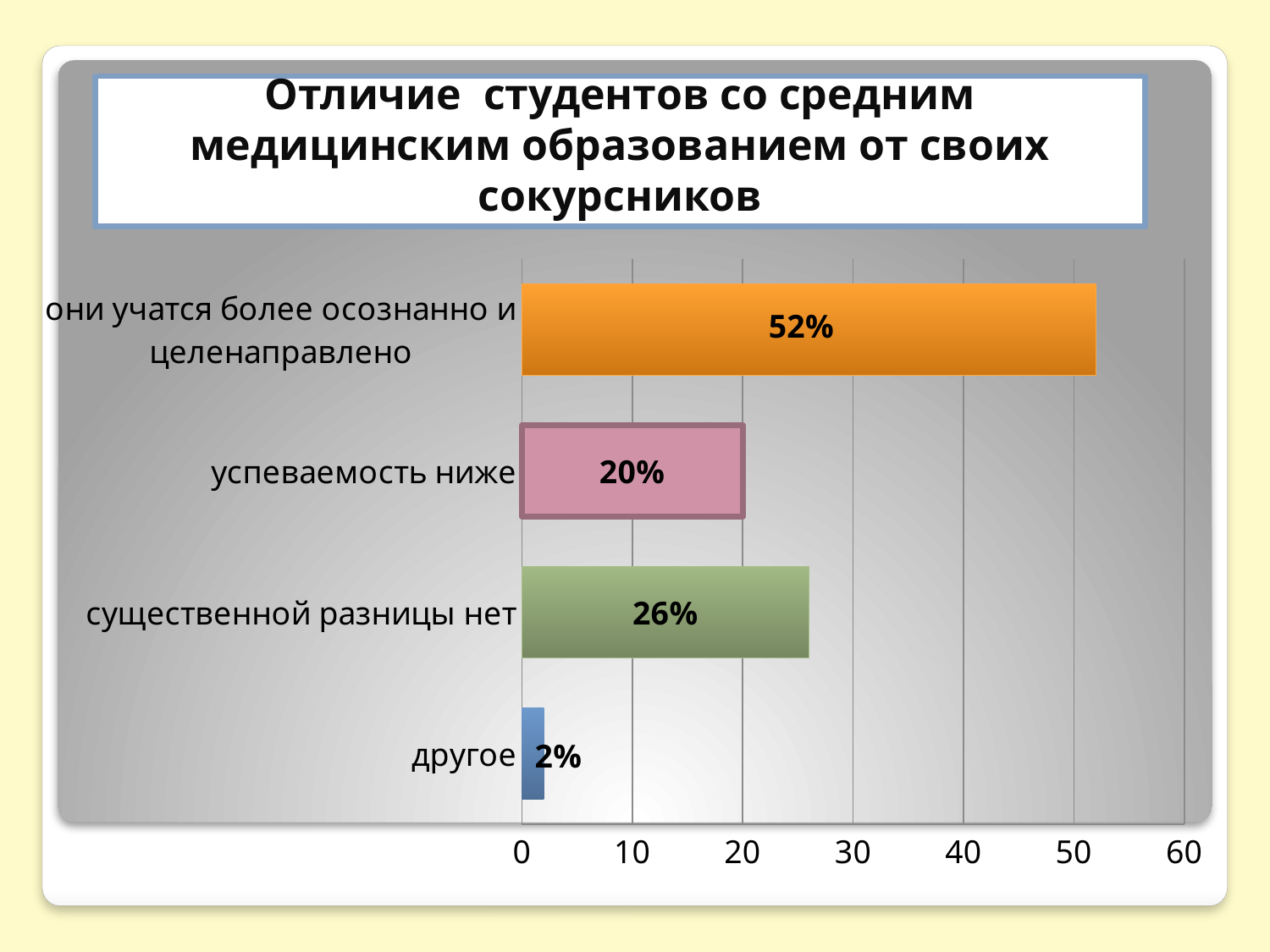
What kind of chart is shown on the slide? bar chart What is the value for "успеваемость ниже"? 20% What is the value for "они учатся более осознанно и целенаправлено"? 52% Which is larger: the value for "успеваемость ниже" or the value for "существенной разницы нет"? существенной разницы нет Which category has the lowest value? другое How many categories are shown in the chart? 4 What is the value for "существенной разницы нет"? 26% Which category has the highest value? они учатся более осознанно и целенаправлено What is the difference between the values for "они учатся более осознанно и целенаправлено" and "существенной разницы нет"? 26% What is the difference between the values for "существенной разницы нет" and "успеваемость ниже"? 6% What is the title of the chart? Отличие студентов со средним медицинским образованием от своих сокурсников What is the value for "другое"? 2%